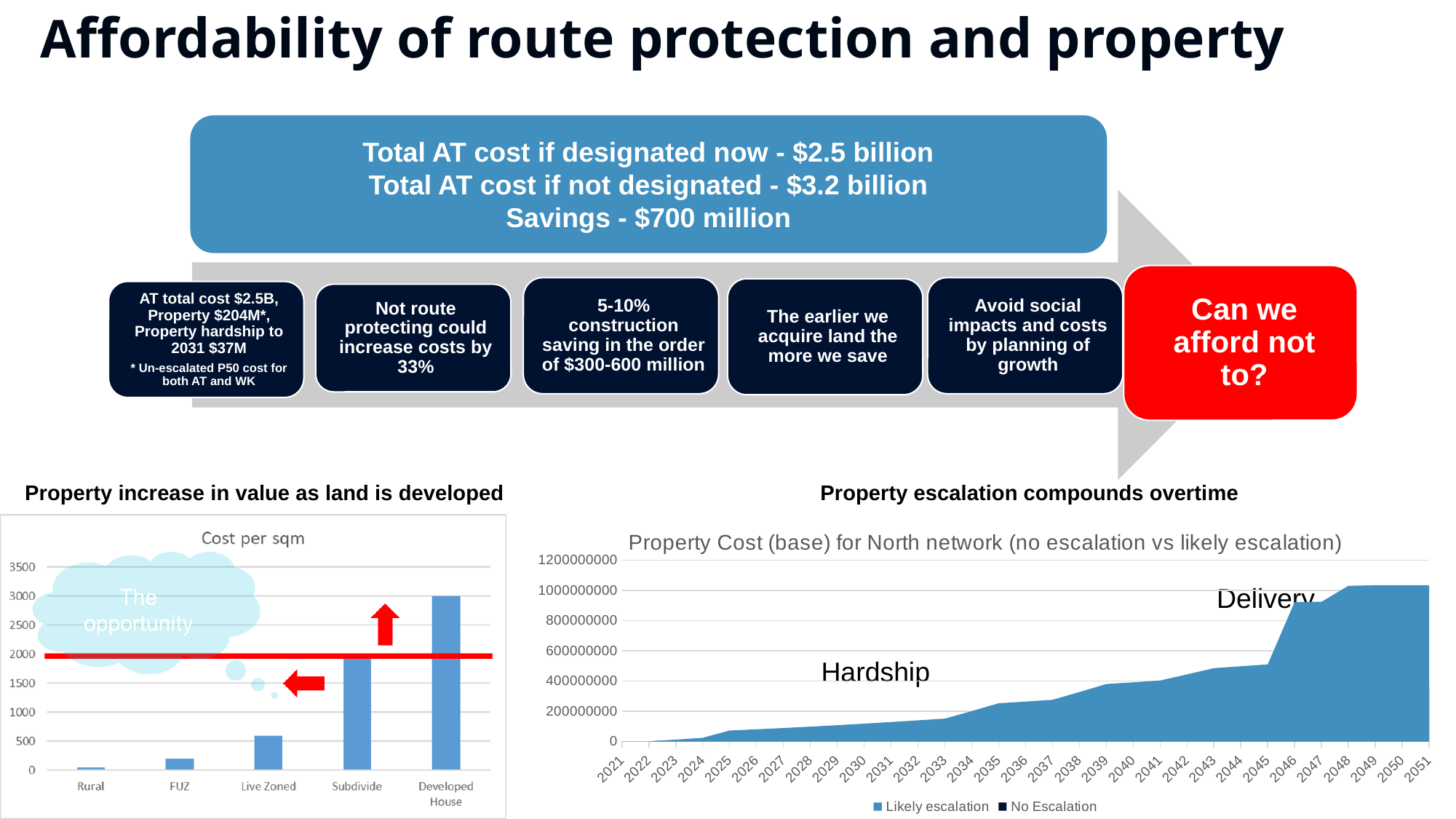
What kind of chart is the 'Cost per sqm' chart on the left? bar chart In the 'Property Cost (base) for North network' chart, is the value for 2033 greater or less than 200000000? less How many series does the legend of the 'Property Cost (base) for North network' chart list? 2 In the 'Cost per sqm' chart, which category has the lowest value? Rural How many categories are shown on the x axis of the 'Cost per sqm' chart? 5 In the 'Cost per sqm' chart, is the value for Live Zoned greater or less than 1000? less In the 'Property Cost (base) for North network' chart, is the value for 2051 greater or less than 800000000? greater In the 'Cost per sqm' chart, which is larger, the value for FUZ or the value for Live Zoned? Live Zoned What are the legend entries of the 'Property Cost (base) for North network' chart? Likely escalation, No Escalation In the 'Cost per sqm' chart, do the values rise or fall from Rural to Developed House? rise In the 'Cost per sqm' chart, which category has the highest value? Developed House